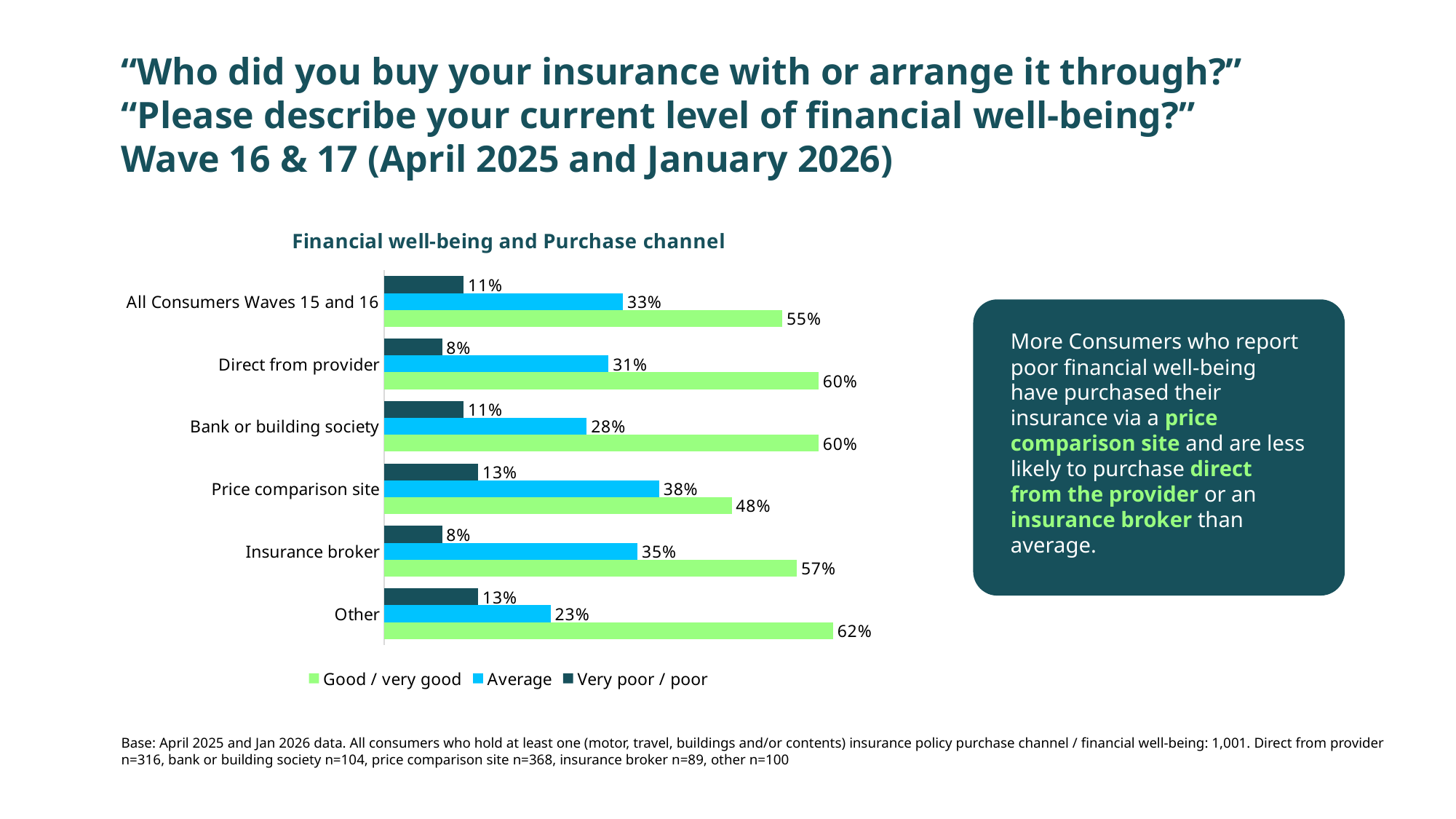
What is the 'Good / very good' value for Price comparison site? 48% What is the difference between the 'Good / very good' values for Direct from provider and Price comparison site? 12% What is the 'Very poor / poor' value for Direct from provider? 8% Which colour represents the 'Very poor / poor' series? Dark teal How many series does the legend list? 3 What is the 'Average' value for Other? 23% Which is larger: the 'Average' value for Price comparison site or for Insurance broker? Price comparison site Which category has the highest 'Good / very good' value? Other Which category has the lowest 'Average' value? Other How many categories are shown on the y axis? 6 What kind of chart is shown? Bar chart What is the title of the chart? Financial well-being and Purchase channel